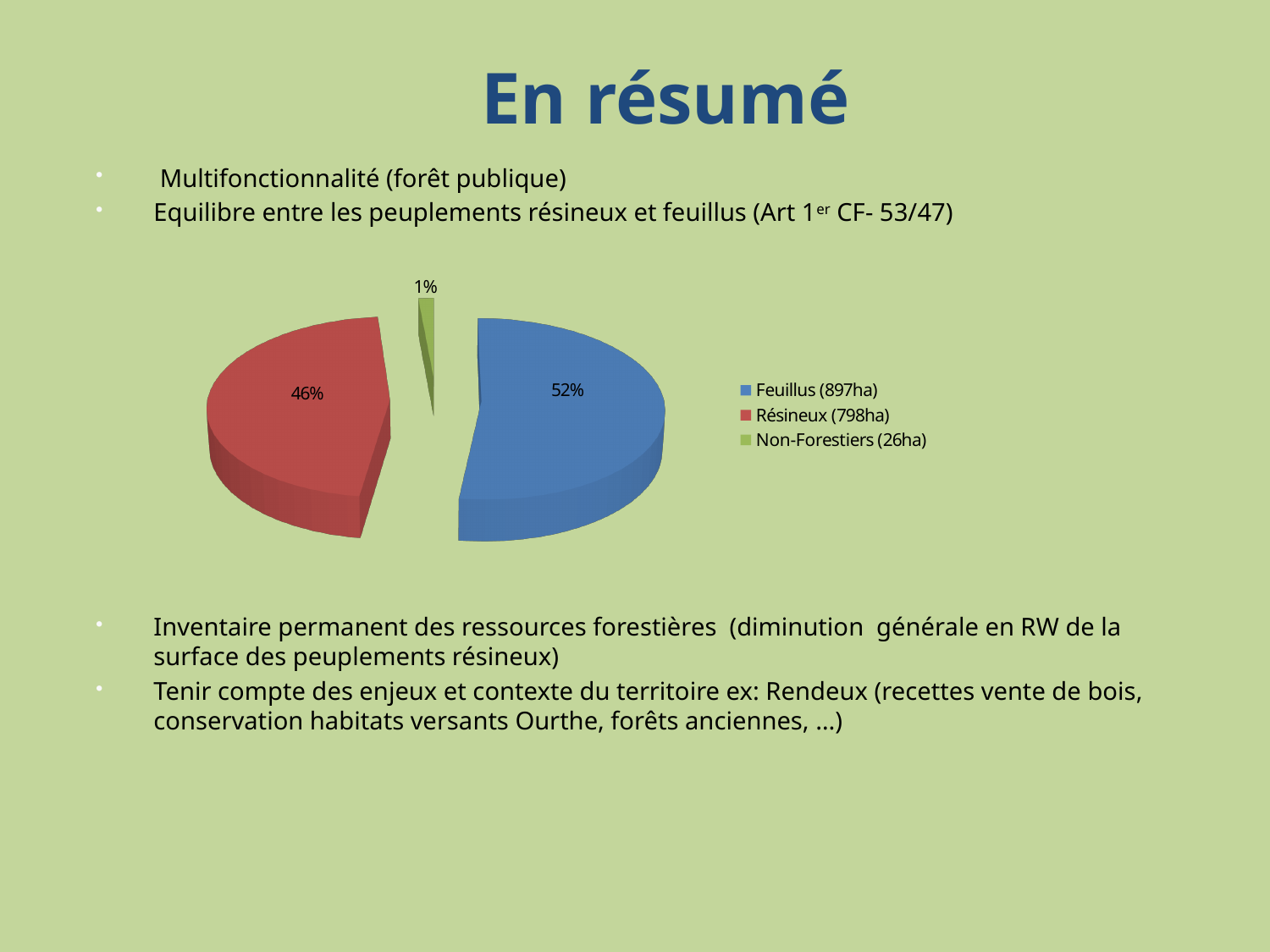
What share of the pie does Résineux (798ha) represent? 46% What kind of chart is shown on the slide? pie chart What share of the pie does Feuillus (897ha) represent? 52% What share of the pie does Non-Forestiers (26ha) represent? 1% How many entries does the legend list? 3 What is the difference in percentage points between the Feuillus and Résineux slices? 6 Which category has the smallest slice of the pie? Non-Forestiers (26ha) What colour is the Résineux (798ha) slice? red Which slice is larger, Feuillus or Résineux? Feuillus What area in hectares is given for Feuillus in the legend? 897ha How many categories does the pie chart show? 3 Which category has the largest slice of the pie? Feuillus (897ha)